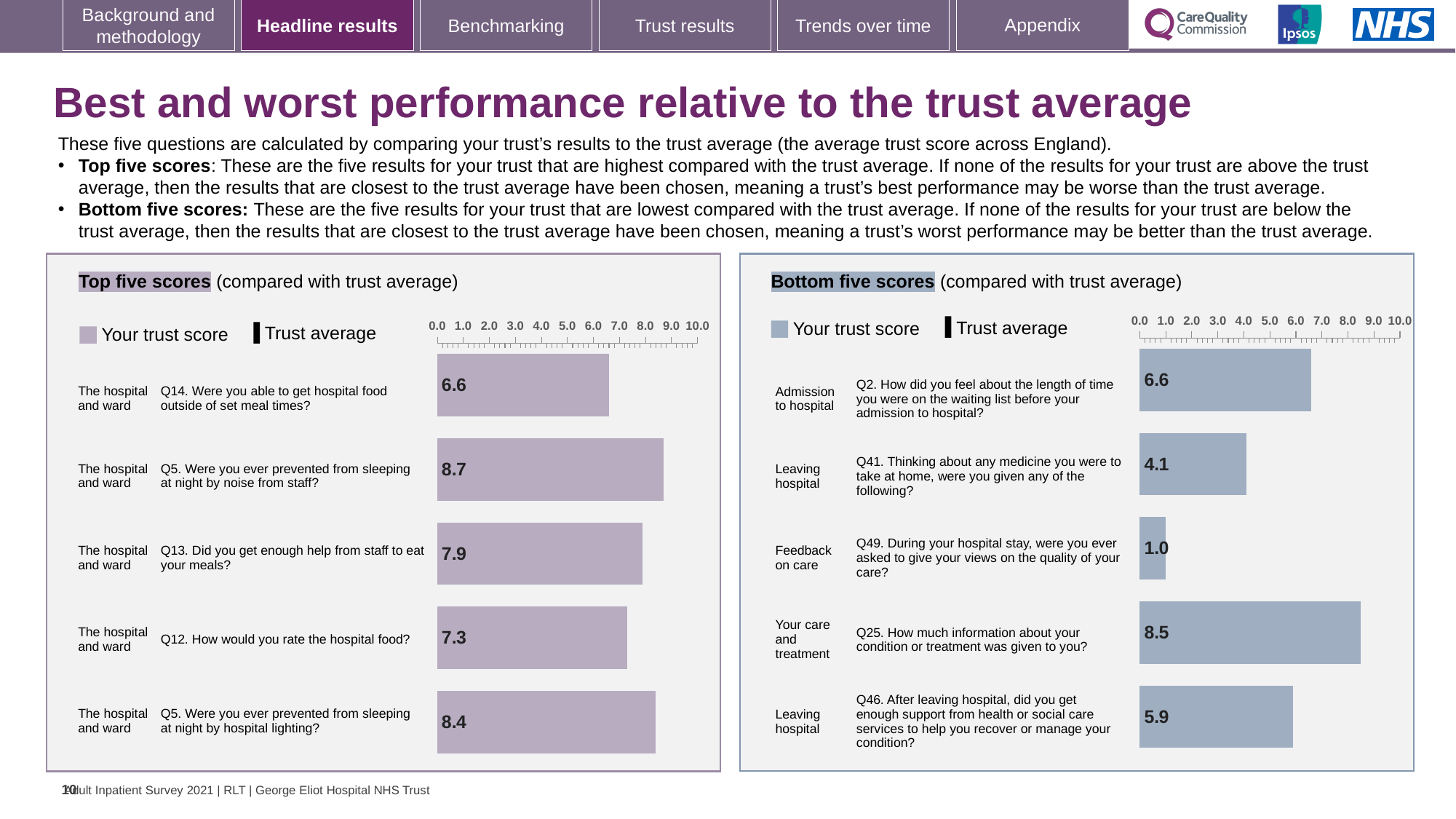
In the Top five scores chart, which question has the highest trust score? Q5. Were you ever prevented from sleeping at night by noise from staff? What type of chart is used for the Top five scores? Bar chart In the Top five scores chart, what is the trust score for Q13 (Did you get enough help from staff to eat your meals?)? 7.9 In the Bottom five scores chart, what is the difference between the scores for Q25 and Q46? 2.6 In the Bottom five scores chart, is the value for Q2 (length of time on the waiting list) greater or less than 5.0? greater In the Top five scores chart, which has a higher score: Q12 (How would you rate the hospital food?) or Q5 (prevented from sleeping by hospital lighting)? Q5 (hospital lighting) In the Top five scores chart, what is the difference between the scores for Q5 (noise from staff) and Q14 (hospital food outside of set meal times)? 2.1 How many series does the legend of the Top five scores chart list? 2 In the Bottom five scores chart, what is the maximum value shown on the axis? 10.0 In the Bottom five scores chart, which question has the lowest trust score? Q49. During your hospital stay, were you ever asked to give your views on the quality of your care? How many questions are shown in the Bottom five scores chart? 5 In the Bottom five scores chart, what is the trust score for Q41 (Thinking about any medicine you were to take at home, were you given any of the following?)? 4.1